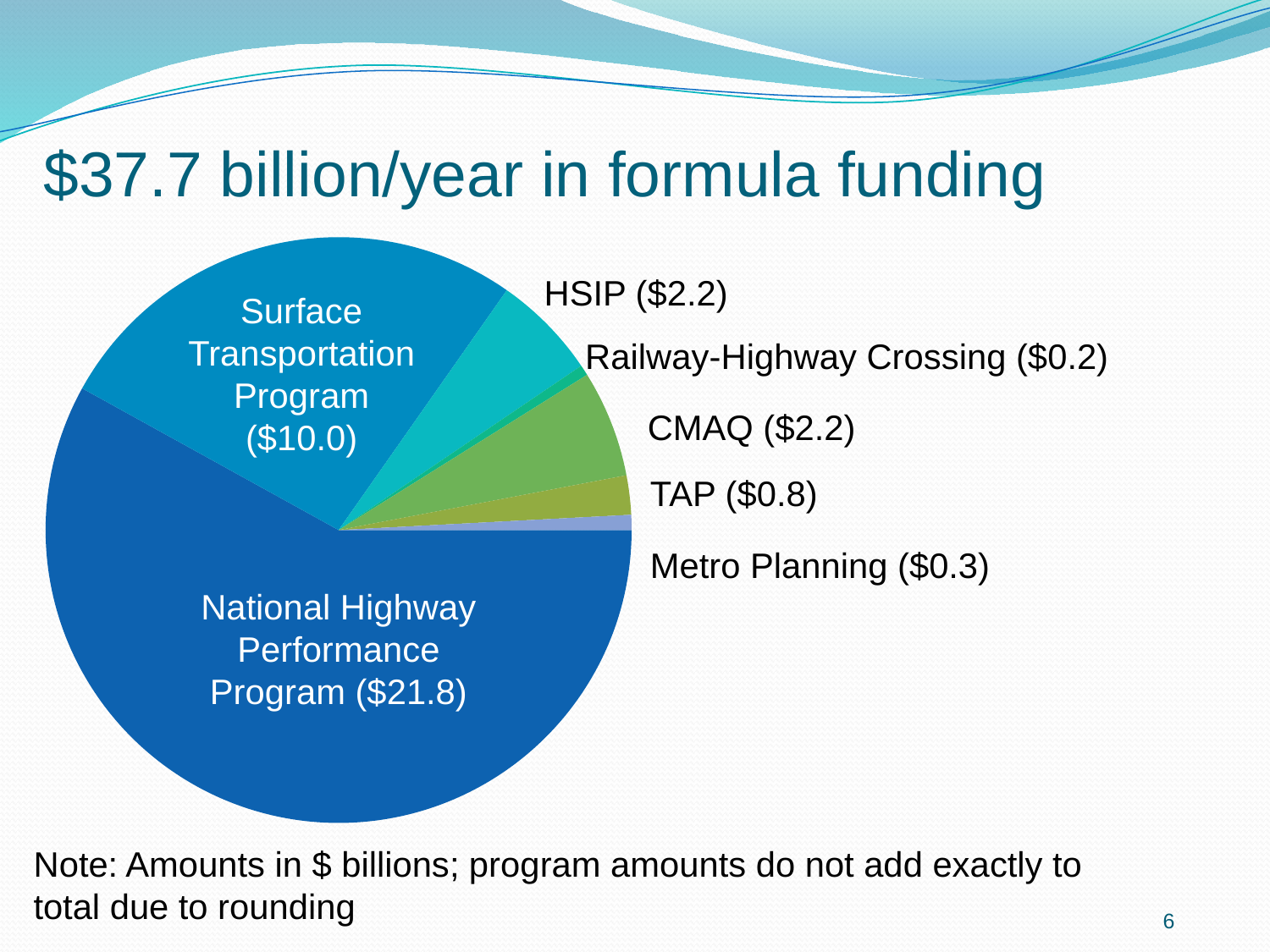
Which program receives the smallest amount of formula funding? Railway-Highway Crossing How many programs are shown in the pie chart? 7 What is the difference between the National Highway Performance Program and the Surface Transportation Program amounts? $11.8 What is the amount for HSIP? $2.2 Which is larger, the amount for CMAQ or the amount for TAP? CMAQ What is the amount for Metro Planning? $0.3 What is the amount for the Surface Transportation Program? $10.0 What is the amount for TAP? $0.8 What type of chart is shown on the slide? Pie chart What is the title of the slide containing the pie chart? $37.7 billion/year in formula funding Which program receives the largest amount of formula funding? National Highway Performance Program What is the amount for the National Highway Performance Program? $21.8